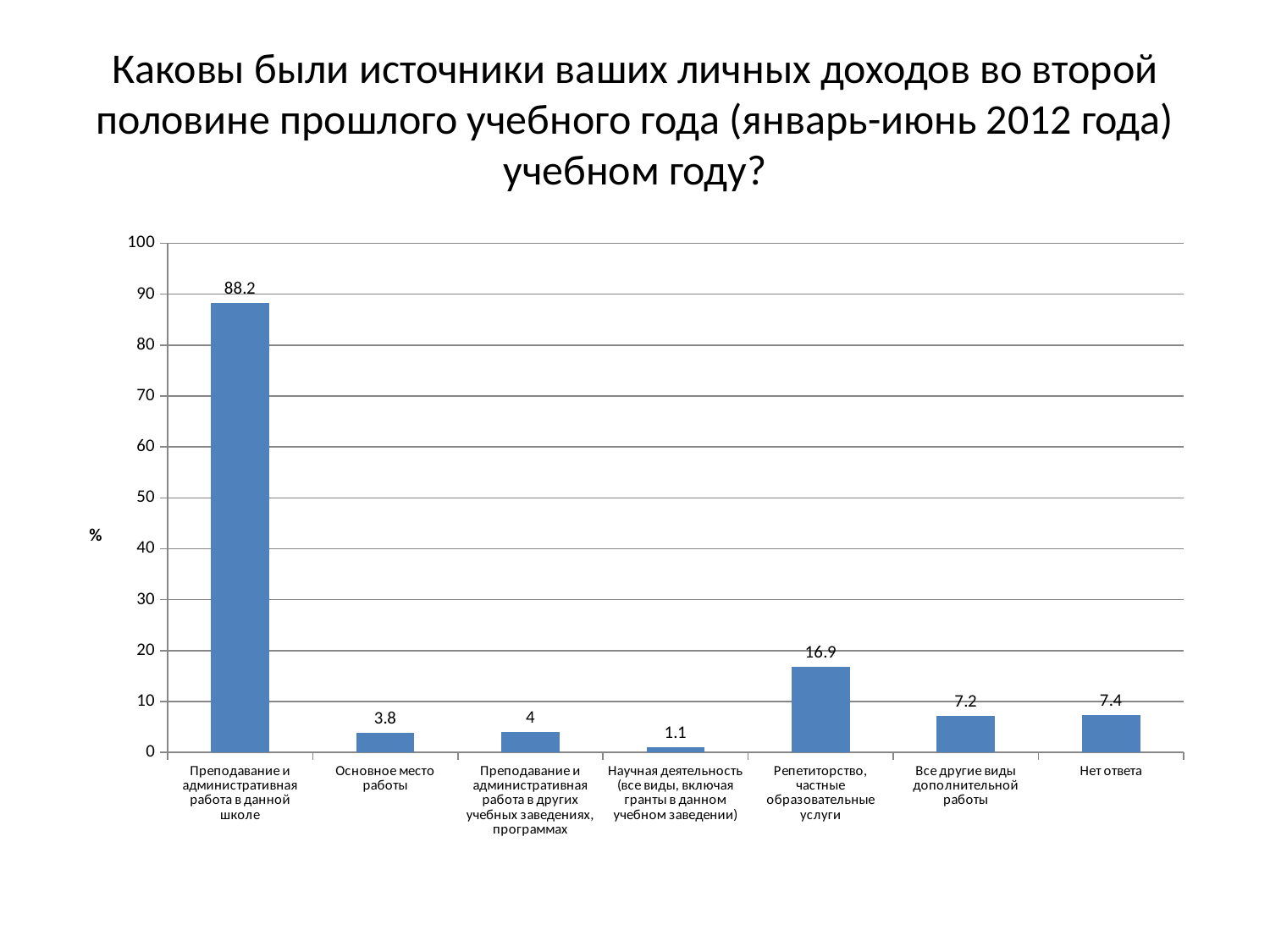
Which category has the lowest value? Научная деятельность (все виды, включая гранты в данном учебном заведении) What is the value for "Нет ответа"? 7.4 Is the value for "Репетиторство, частные образовательные услуги" greater or less than 20? less What is the label on the vertical axis? % What is the difference between the values for "Репетиторство, частные образовательные услуги" and "Все другие виды дополнительной работы"? 9.7 What is the value for "Преподавание и административная работа в данной школе"? 88.2 What is the value for "Научная деятельность (все виды, включая гранты в данном учебном заведении)"? 1.1 What is the value for "Репетиторство, частные образовательные услуги"? 16.9 Which is larger: the value for "Основное место работы" or the value for "Преподавание и административная работа в других учебных заведениях, программах"? Преподавание и административная работа в других учебных заведениях, программах What kind of chart is shown on the slide? bar chart How many categories are shown on the x axis? 7 Which category has the highest value? Преподавание и административная работа в данной школе